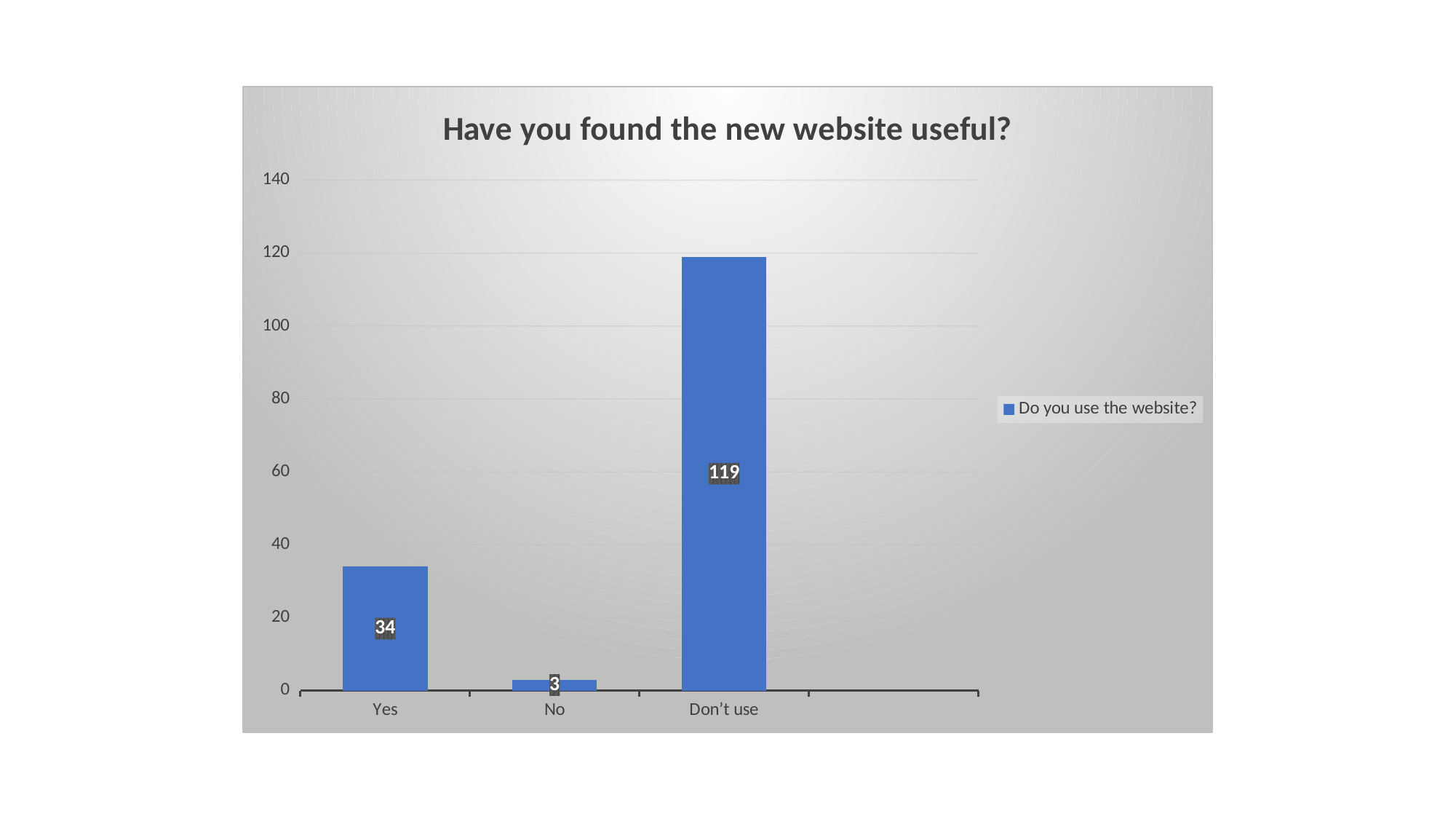
What is the value for "Don't use"? 119 Which category has the highest value? Don't use What is the difference between the values for "Don't use" and "Yes"? 85 How many categories are shown on the x axis? 3 What is the value for "No"? 3 Is the value for "Don't use" greater or less than 100? greater Which category has the lowest value? No Which is larger, the value for "Yes" or the value for "No"? Yes What is the difference between the values for "Yes" and "No"? 31 What is the title of the chart? Have you found the new website useful? What is the value for "Yes"? 34 What kind of chart is shown on the slide? bar chart